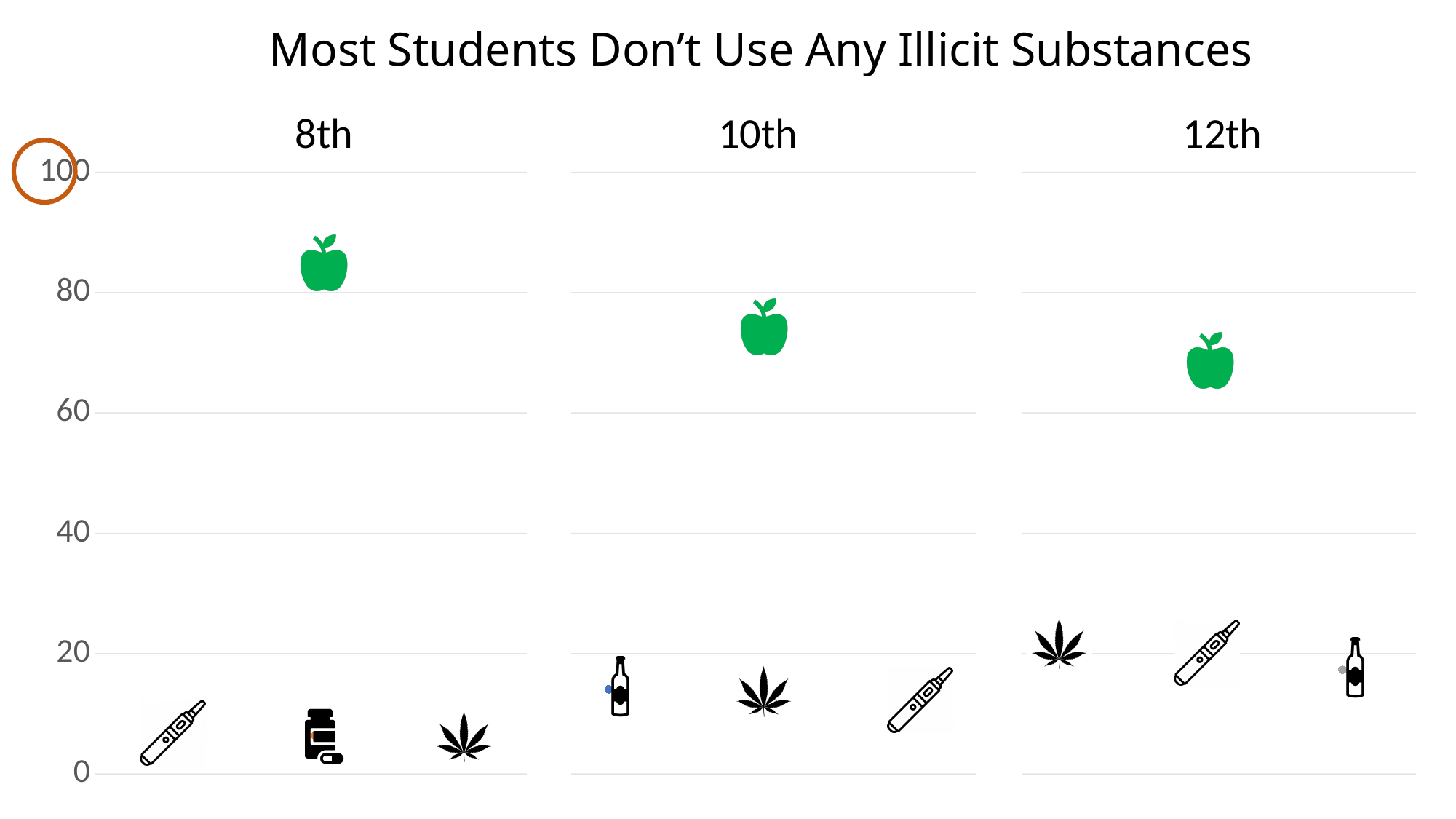
Is the green apple icon higher in the 8th grade panel or the 12th grade panel? 8th Is the value for the green apple icon in the 8th grade panel greater or less than 80? greater Which grade panel has the highest green apple icon? 8th Is the value for the green apple icon in the 12th grade panel greater or less than 60? greater Which grade panel has the lowest green apple icon? 12th How many grade panels does the chart show? 3 What is the highest value shown on the vertical axis? 100 Are all the non-apple icons in the 8th grade panel greater or less than 20? less Which grades are labelled across the top of the chart? 8th, 10th, 12th Does the green apple icon rise or fall from the 8th grade panel to the 12th grade panel? fall What is the title of the chart? Most Students Don't Use Any Illicit Substances